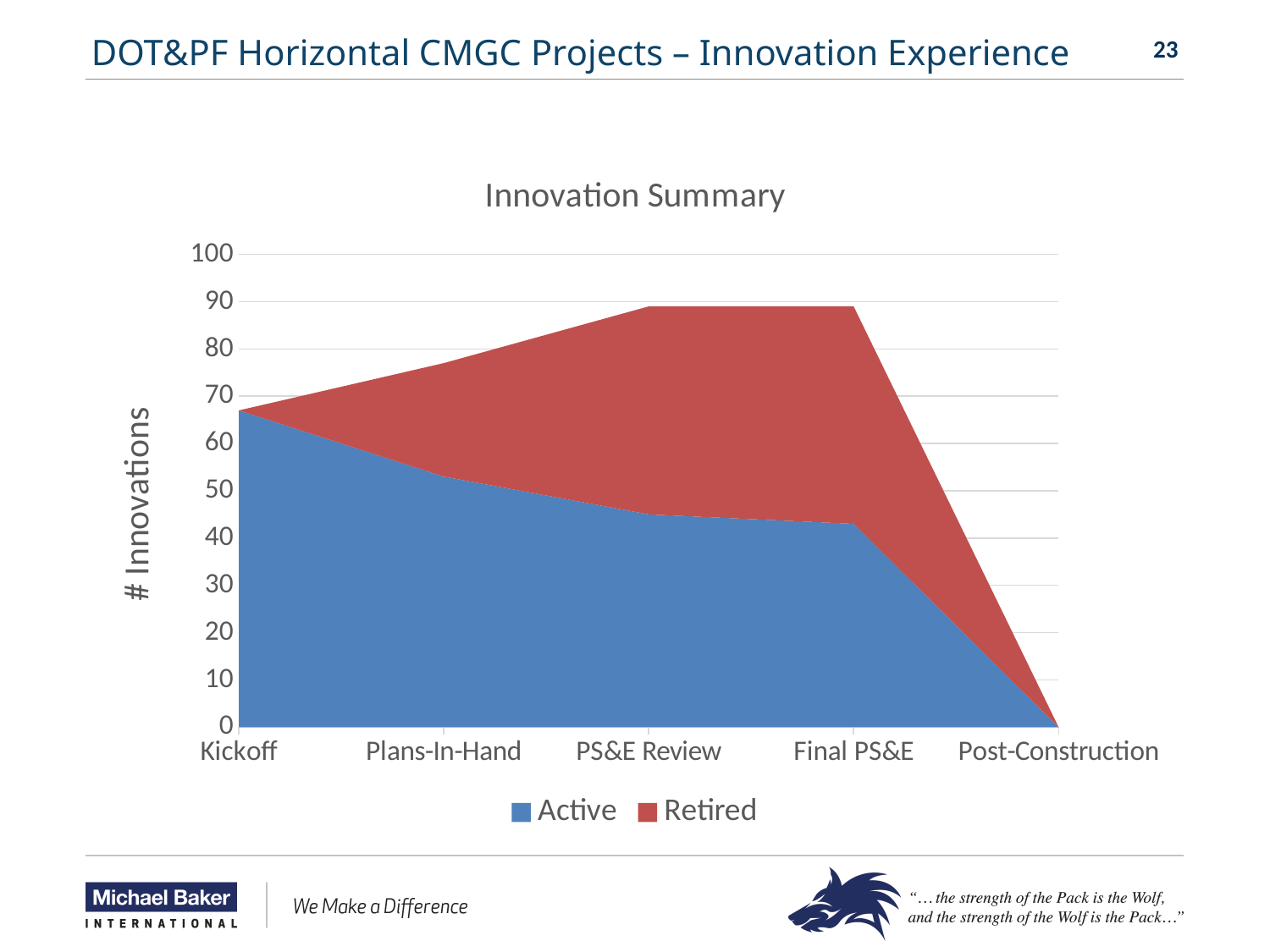
At which phase is the Active series highest? Kickoff How many series does the legend list? 2 What is the value of the Active series at Post-Construction? 0 Which is larger, the Active value at Kickoff or the Active value at PS&E Review? Kickoff How many project phases are shown along the x axis? 5 Is the value of the Active series at Final PS&E greater or less than 50? less What is the title of the chart? Innovation Summary What is the label of the vertical axis? # Innovations Does the Active series rise or fall from Kickoff to Post-Construction? fall Is the value of the Active series at Plans-In-Hand greater or less than 50? greater What kind of chart is shown on the slide? area chart Is the value of the Active series at Kickoff greater or less than 60? greater